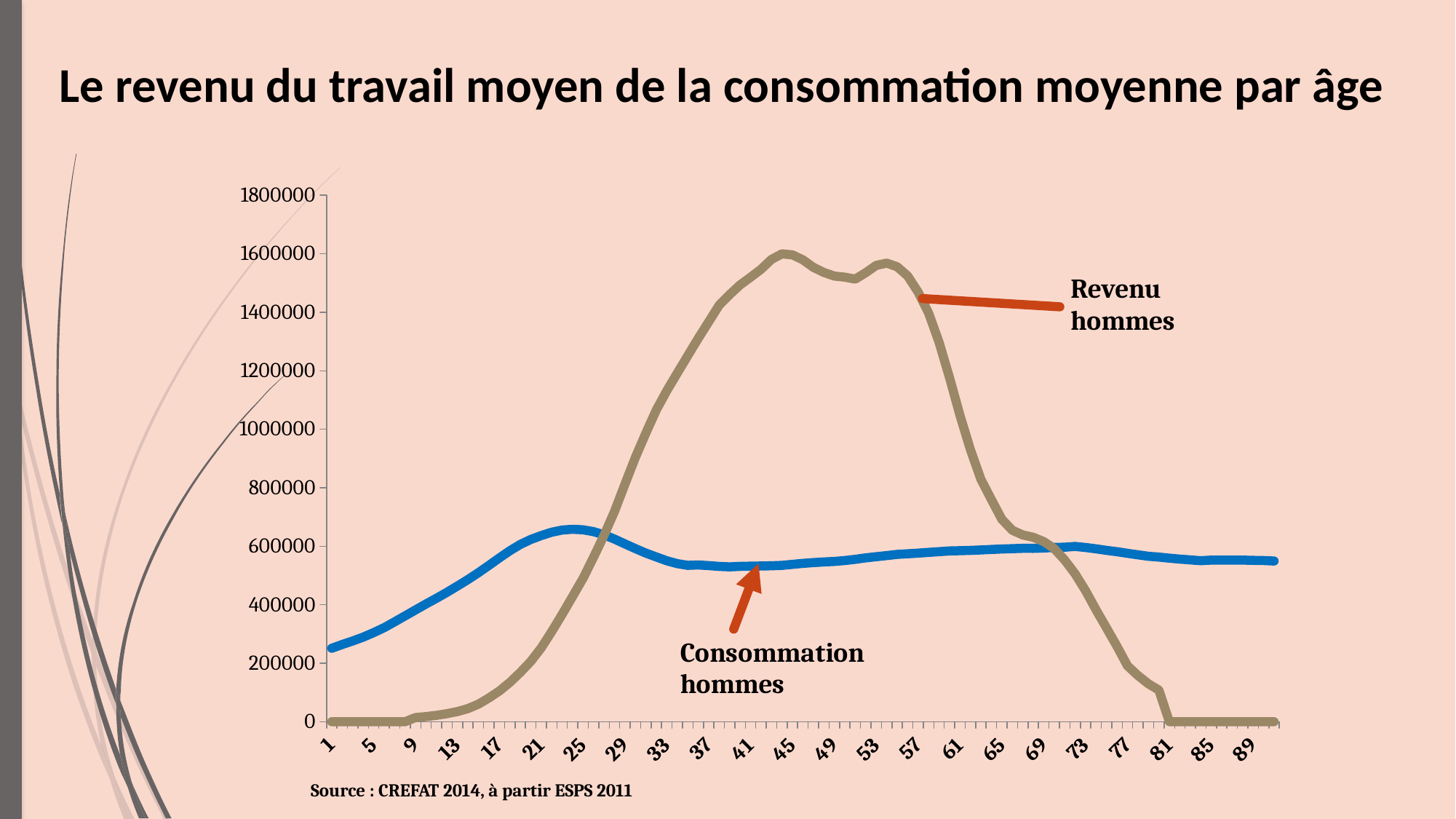
Is the value of Consommation hommes at age 25 greater or less than 600000? greater Is the value of Revenu hommes at age 45 greater or less than 1400000? greater How many data series are plotted on the chart? 2 Does the Revenu hommes line rise or fall between age 57 and age 81? fall At age 13, which series has the larger value, Revenu hommes or Consommation hommes? Consommation hommes What kind of chart is shown on the slide? line chart Is the value of Revenu hommes at age 5 greater or less than 200000? less What is the highest value shown on the vertical axis? 1800000 At age 45, which series has the larger value, Revenu hommes or Consommation hommes? Revenu hommes What source is cited below the chart? CREFAT 2014, à partir ESPS 2011 Which series reaches the highest value on the chart? Revenu hommes